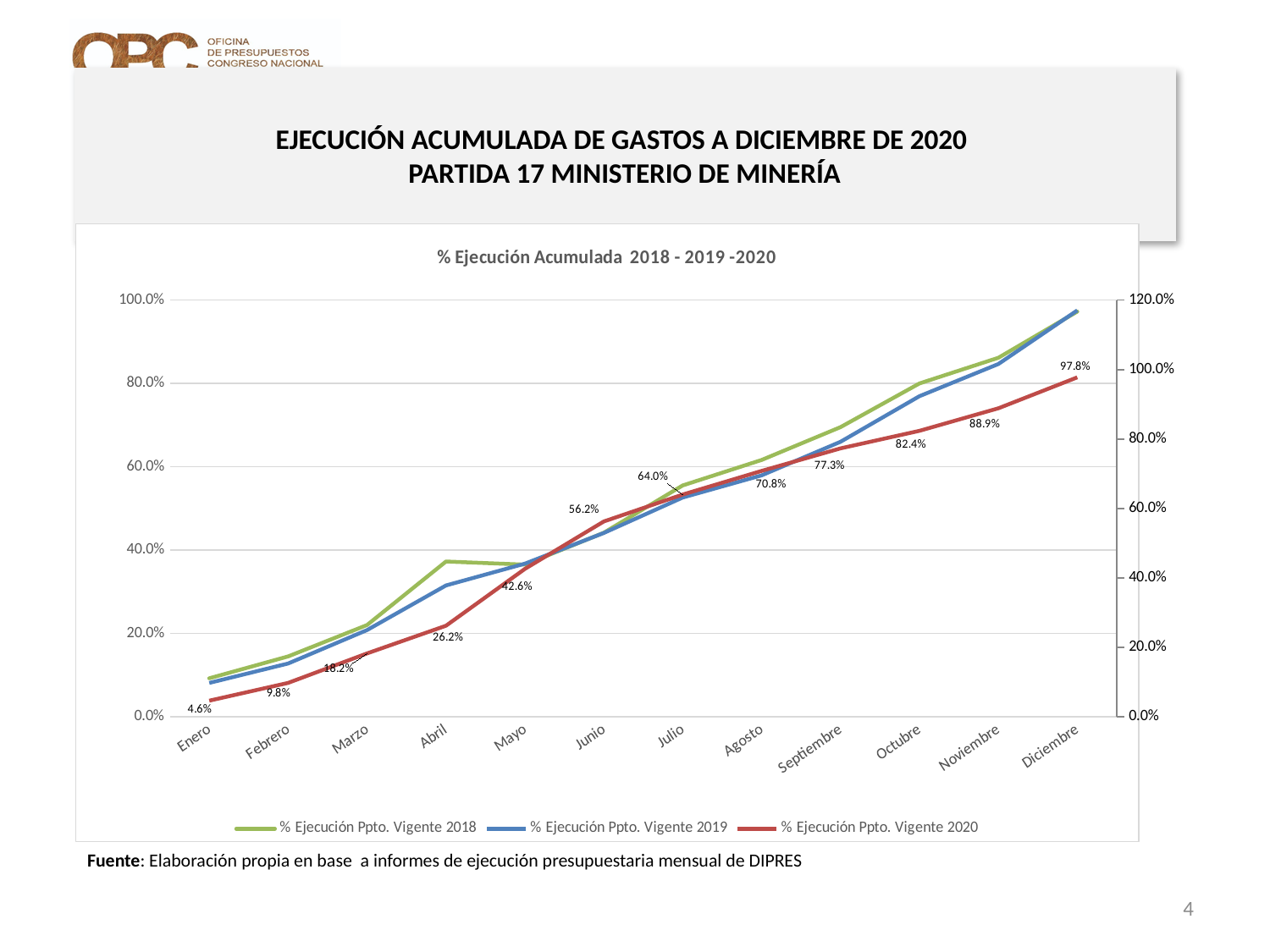
What is the title of the chart? % Ejecución Acumulada 2018 - 2019 -2020 Which month has the lowest value in the % Ejecución Ppto. Vigente 2020 series? Enero What is the difference between the Junio and Mayo values in the % Ejecución Ppto. Vigente 2020 series? 13.6% What is the value for Enero in the % Ejecución Ppto. Vigente 2020 series? 4.6% How many series does the legend list? 3 How many months are plotted along the x axis? 12 What is the difference between the Diciembre and Noviembre values in the % Ejecución Ppto. Vigente 2020 series? 8.9% What kind of chart is shown on the slide? line chart Do the values of the % Ejecución Ppto. Vigente 2020 series rise or fall from Enero to Diciembre? rise Which month has the highest value in the % Ejecución Ppto. Vigente 2020 series? Diciembre What is the value for Diciembre in the % Ejecución Ppto. Vigente 2020 series? 97.8% What is the value for Julio in the % Ejecución Ppto. Vigente 2020 series? 64.0%